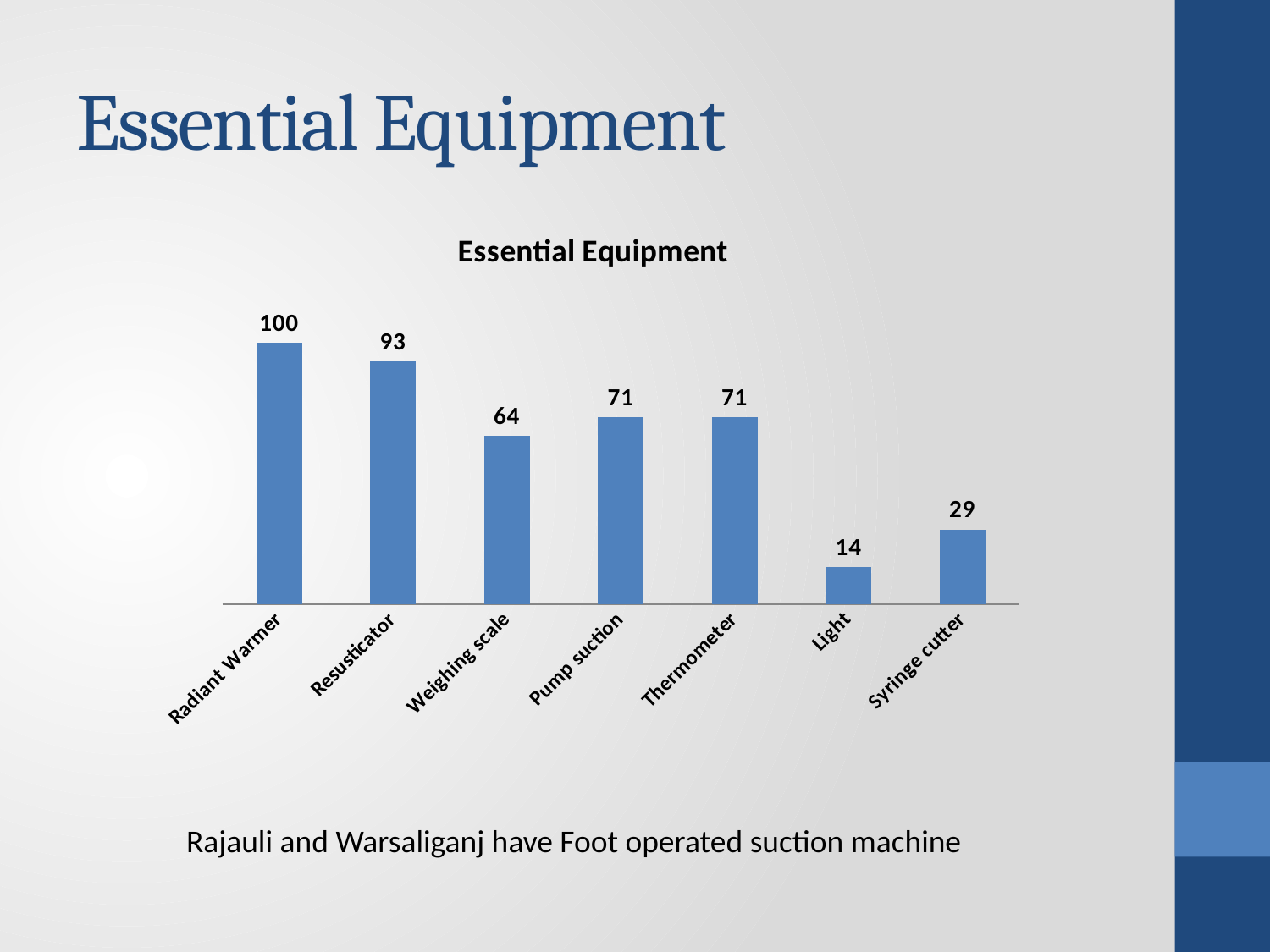
Which category has the lowest value? Light What is the value for Weighing scale? 64 What is the value for Radiant Warmer? 100 Which is larger, the value for Resusticator or the value for Thermometer? Resusticator What is the difference between the values for Resusticator and Light? 79 What is the value for Syringe cutter? 29 What is the title of the chart? Essential Equipment How many categories are shown in the chart? 7 What is the difference between the values for Pump suction and Weighing scale? 7 What kind of chart is shown on the slide? Bar chart Which two categories share the same value of 71? Pump suction and Thermometer Which category has the highest value? Radiant Warmer